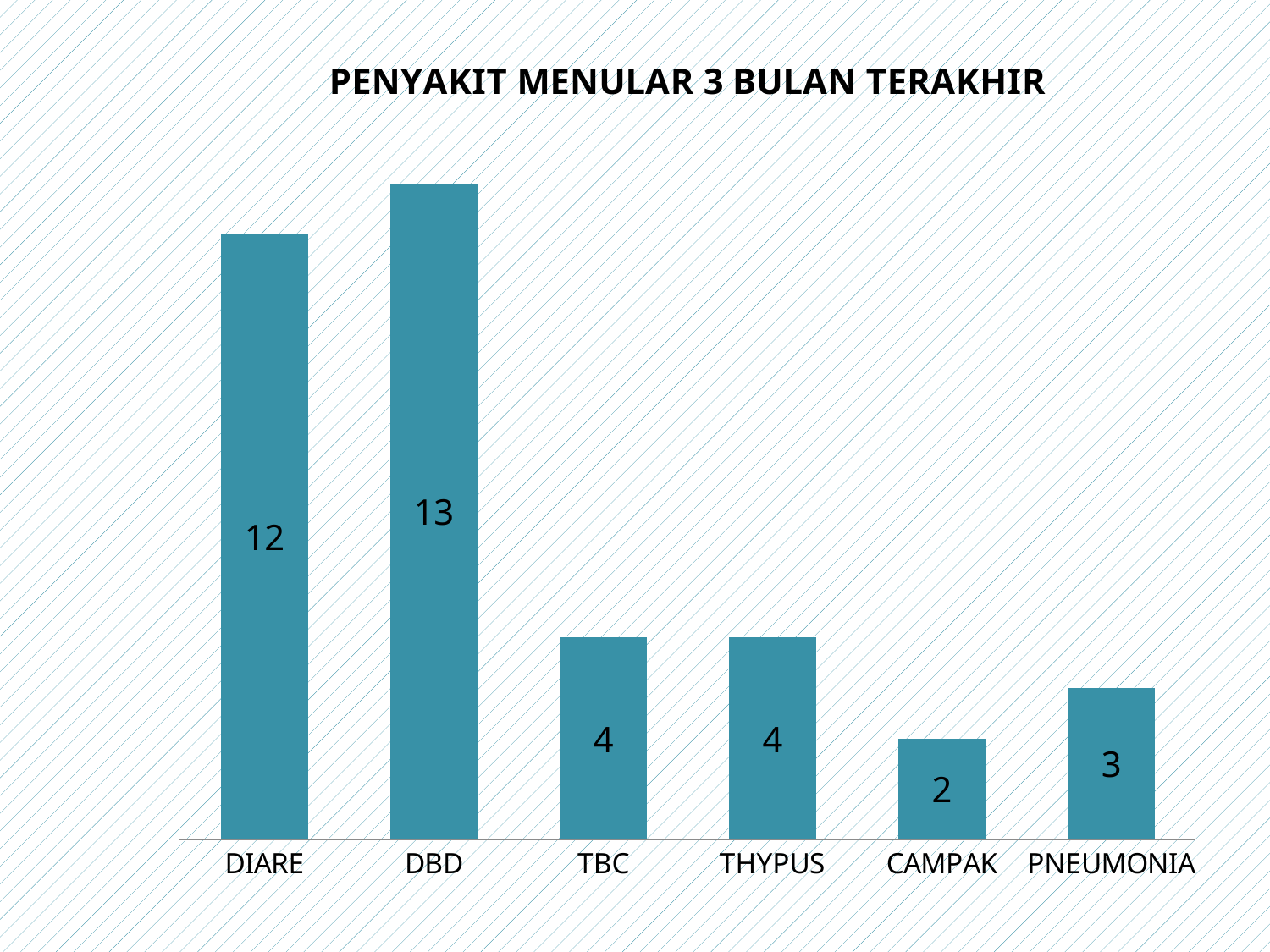
What is the value for PNEUMONIA? 3 What is the difference between the values for TBC and CAMPAK? 2 What kind of chart is this? bar chart Which category has the lowest value? CAMPAK What is the difference between the values for DBD and DIARE? 1 How many categories are shown on the chart? 6 What is the value for DIARE? 12 Which is larger, the value for PNEUMONIA or the value for CAMPAK? PNEUMONIA What is the value for CAMPAK? 2 What is the title of the chart? PENYAKIT MENULAR 3 BULAN TERAKHIR Which category has the highest value? DBD What is the value for DBD? 13